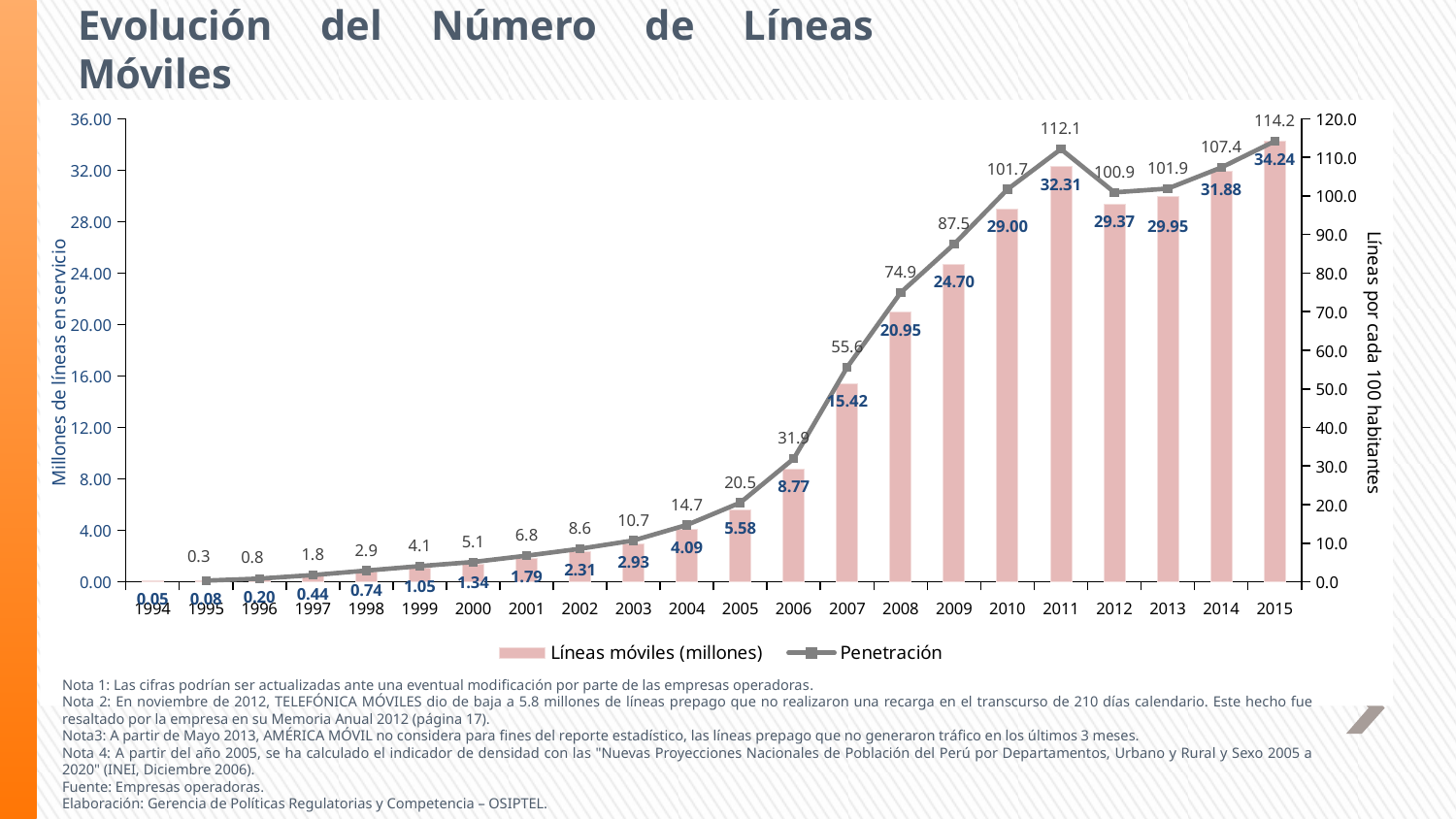
How many years are shown on the x axis? 22 What is the difference in Líneas móviles (millones) between 2011 and 2012? 2.94 Which year has a higher Penetración value, 2012 or 2013? 2013 What is the title of the chart? Evolución del Número de Líneas Móviles In which year is the Líneas móviles (millones) value lowest? 1994 In which year is the Penetración value highest? 2015 What is the value of Líneas móviles (millones) for 2008? 20.95 What is the Penetración value for 2011? 112.1 What is the Penetración value for 2007? 55.6 How many series does the legend list? 2 What kind of chart is this? Combined bar and line chart What is the value of Líneas móviles (millones) for 2015? 34.24